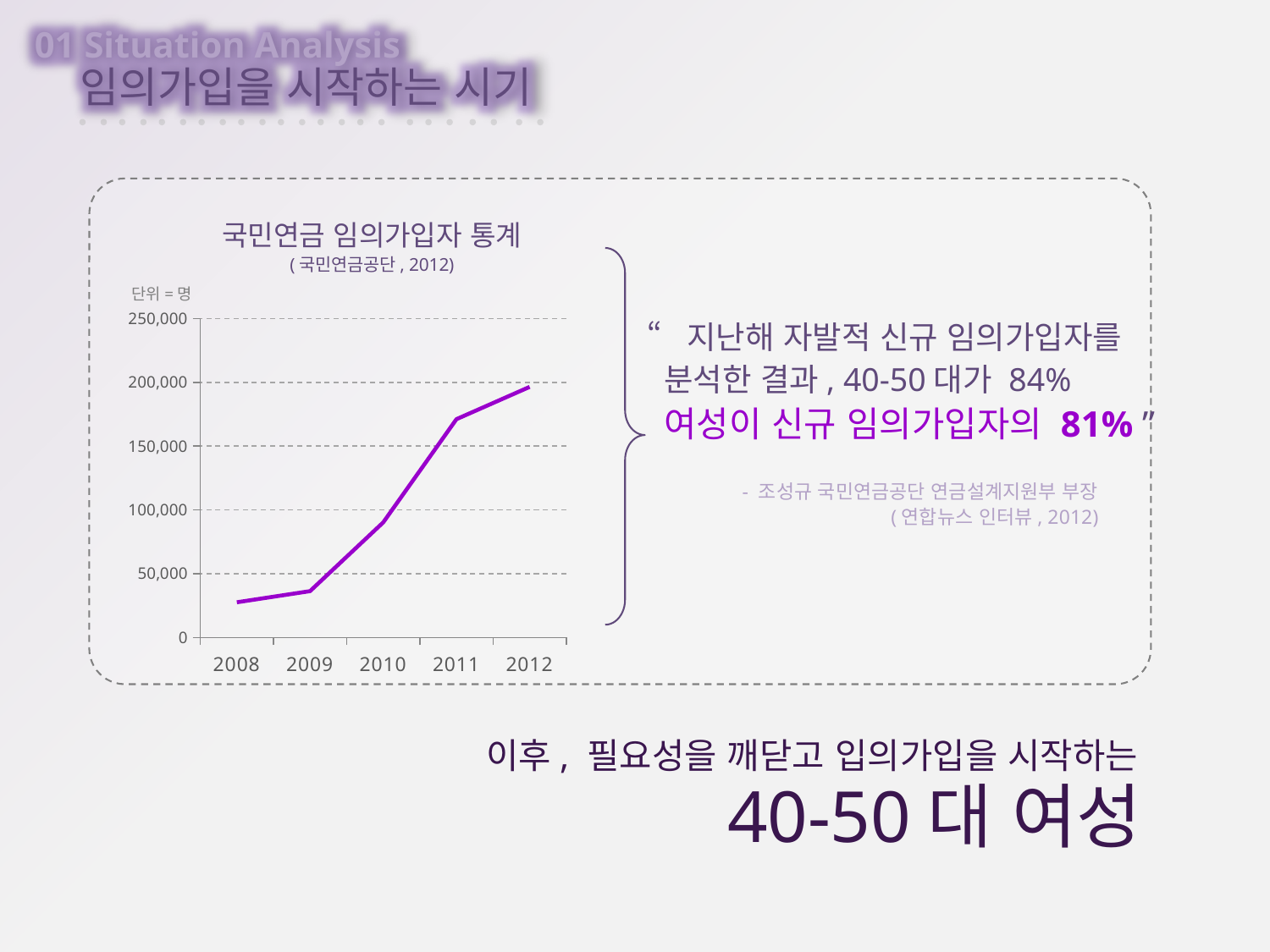
Do the values in the chart rise or fall from 2008 to 2012? rise Is the value for 2011 greater or less than 150,000? greater Which year has the larger value, 2009 or 2011? 2011 What kind of chart is shown on the slide? line chart Which year has the lowest value in the chart? 2008 Is the value for 2008 greater or less than 50,000? less What unit is stated for the chart's values? 명 What is the title of the chart? 국민연금 임의가입자 통계 Which year has the highest value in the chart? 2012 Is the value for 2012 greater or less than 150,000? greater How many years are plotted on the x axis of the chart? 5